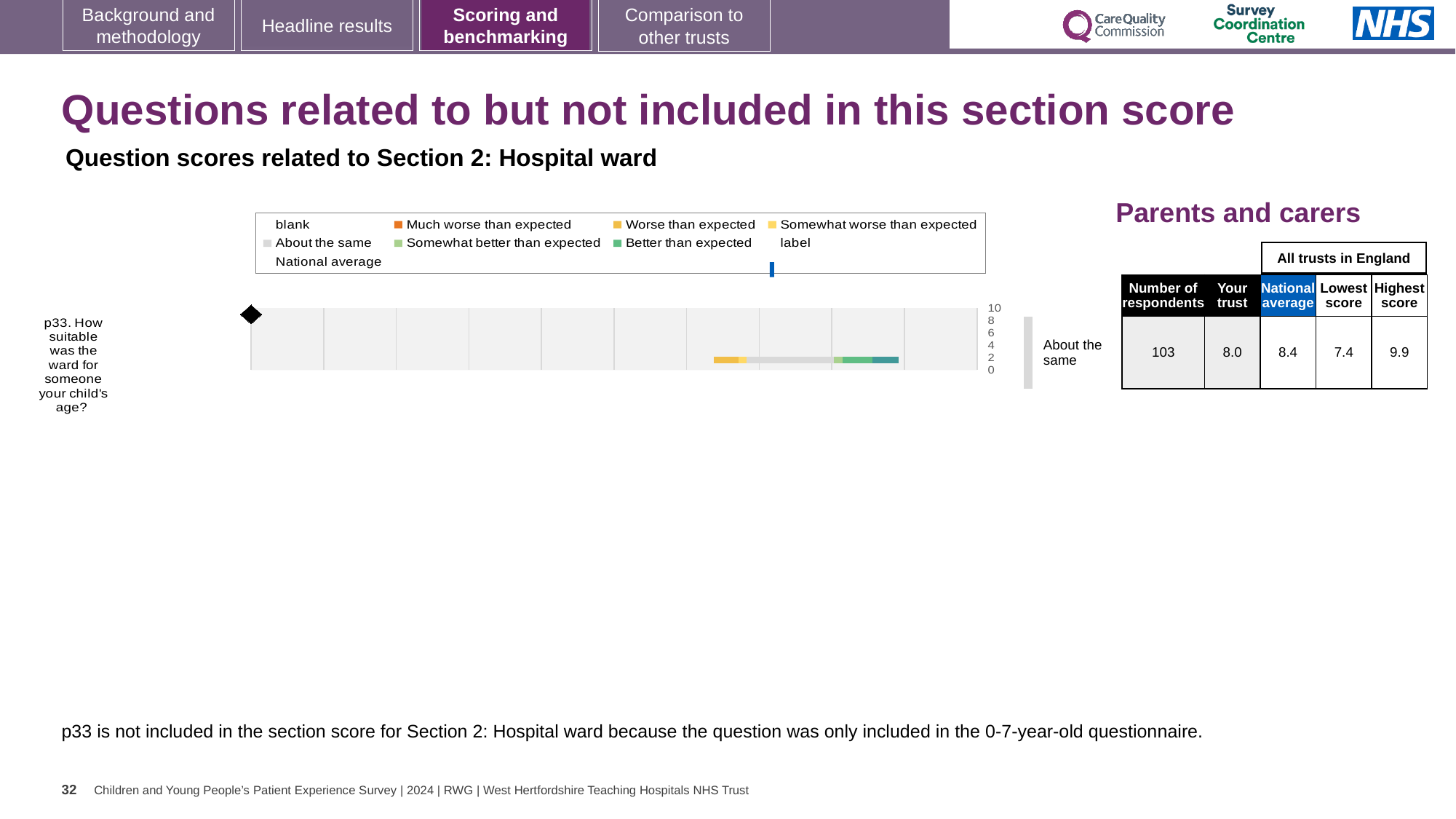
How many respondents answered p33? 103 What benchmark category is shown next to the p33 bar? About the same What is the 'Your trust' score for p33 (How suitable was the ward for someone your child's age?)? 8.0 Which is larger for p33: the trust's score or the national average? National average What is the lowest score among all trusts in England for p33? 7.4 What is the highest score among all trusts in England for p33? 9.9 What kind of chart is used to show the p33 question score? Bar chart By how much does the national average exceed the trust's score for p33? 0.4 What is the national average score for p33? 8.4 How many questions are plotted in the chart? 1 Which respondent group does the chart relate to? Parents and carers What is the difference between the highest and lowest trust scores for p33? 2.5